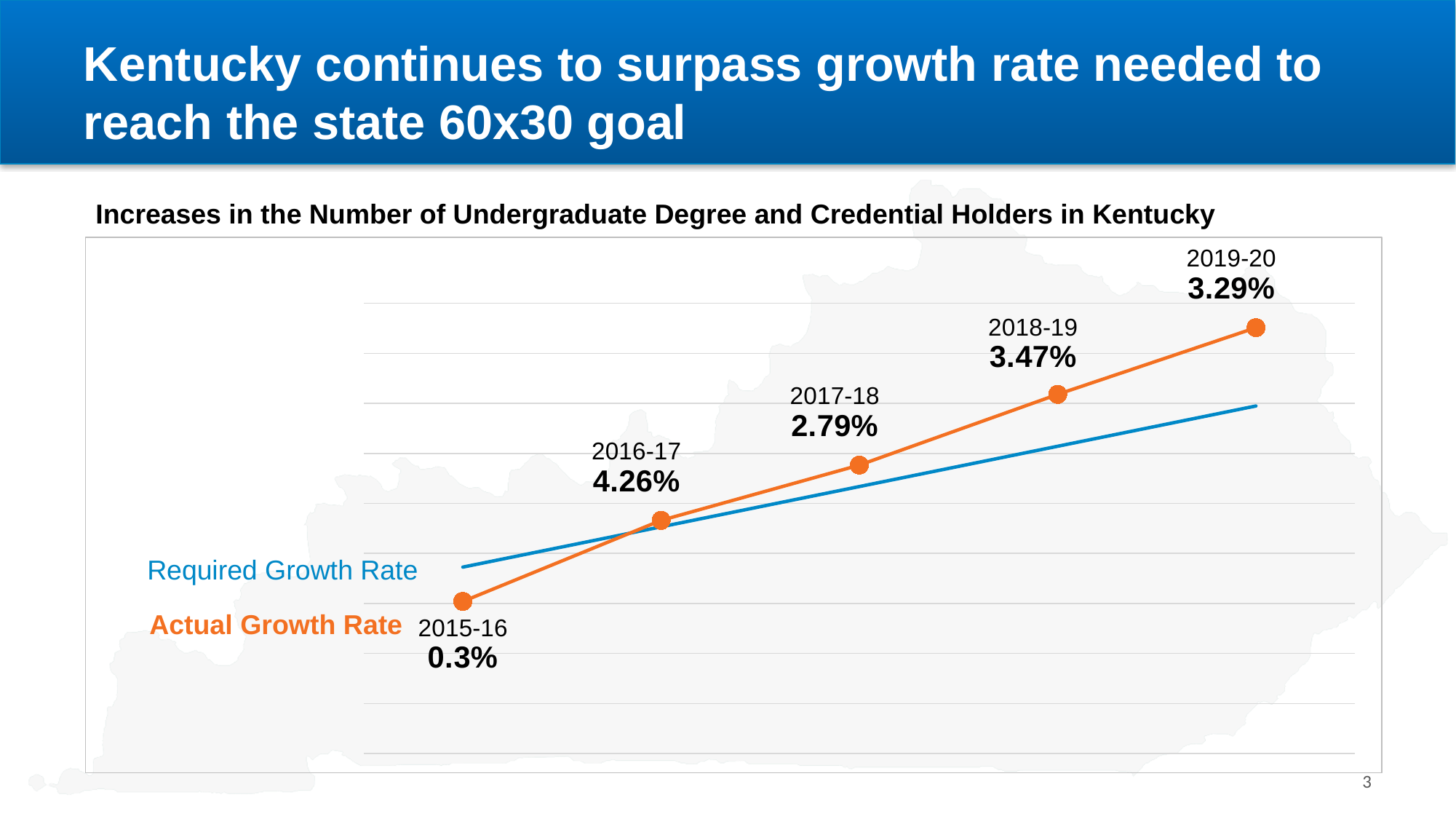
Which year has the highest labeled Actual Growth Rate? 2016-17 What is the Actual Growth Rate for 2015-16? 0.3% What is the Actual Growth Rate for 2016-17? 4.26% Which labeled Actual Growth Rate is larger, 2018-19 or 2019-20? 2018-19 How many data points are plotted on the Actual Growth Rate line? 5 What is the difference between the labeled Actual Growth Rate for 2016-17 and 2017-18? 1.47% What is the Actual Growth Rate for 2018-19? 3.47% What colour is the Required Growth Rate line? Blue How many series are plotted on the chart? 2 What is the Actual Growth Rate for 2019-20? 3.29% Which year has the lowest labeled Actual Growth Rate? 2015-16 What kind of chart is shown on the slide? Line chart